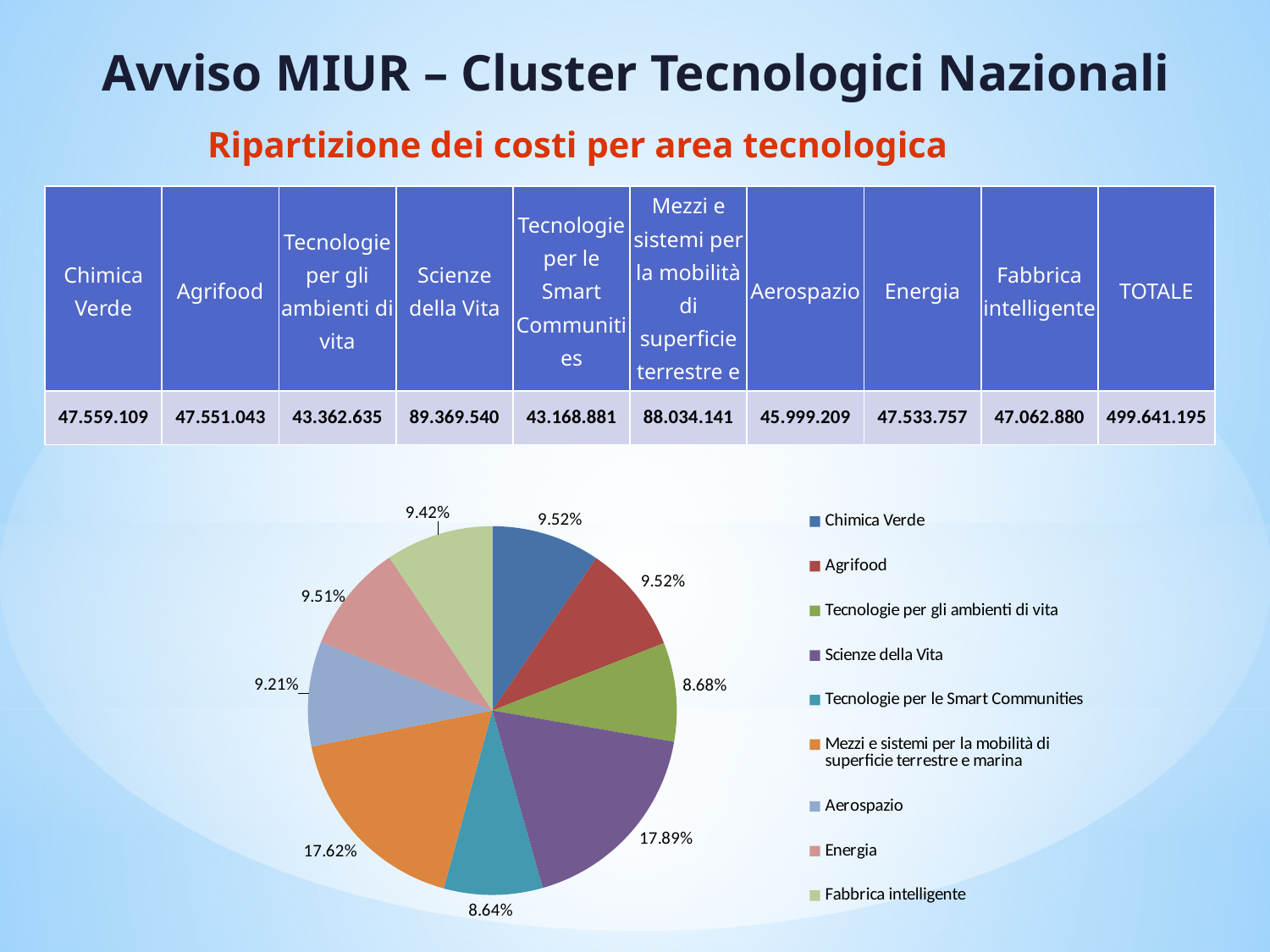
How many slices does the pie chart have? 9 What percentage is shown for Aerospazio in the pie chart? 9.21% Which slice is larger in the pie chart, Energia or Aerospazio? Energia What type of chart is shown on the slide? pie chart What percentage is shown for Fabbrica intelligente in the pie chart? 9.42% What is the difference in percentage points between the Scienze della Vita slice and the Mezzi e sistemi per la mobilità di superficie terrestre e marina slice? 0.27% What percentage is shown for Mezzi e sistemi per la mobilità di superficie terrestre e marina in the pie chart? 17.62% What share of the pie does Scienze della Vita represent? 17.89% Which category has the smallest slice in the pie chart? Tecnologie per le Smart Communities How many entries does the pie chart's legend list? 9 Which category has the largest slice in the pie chart? Scienze della Vita What colour is the Scienze della Vita slice in the pie chart? purple